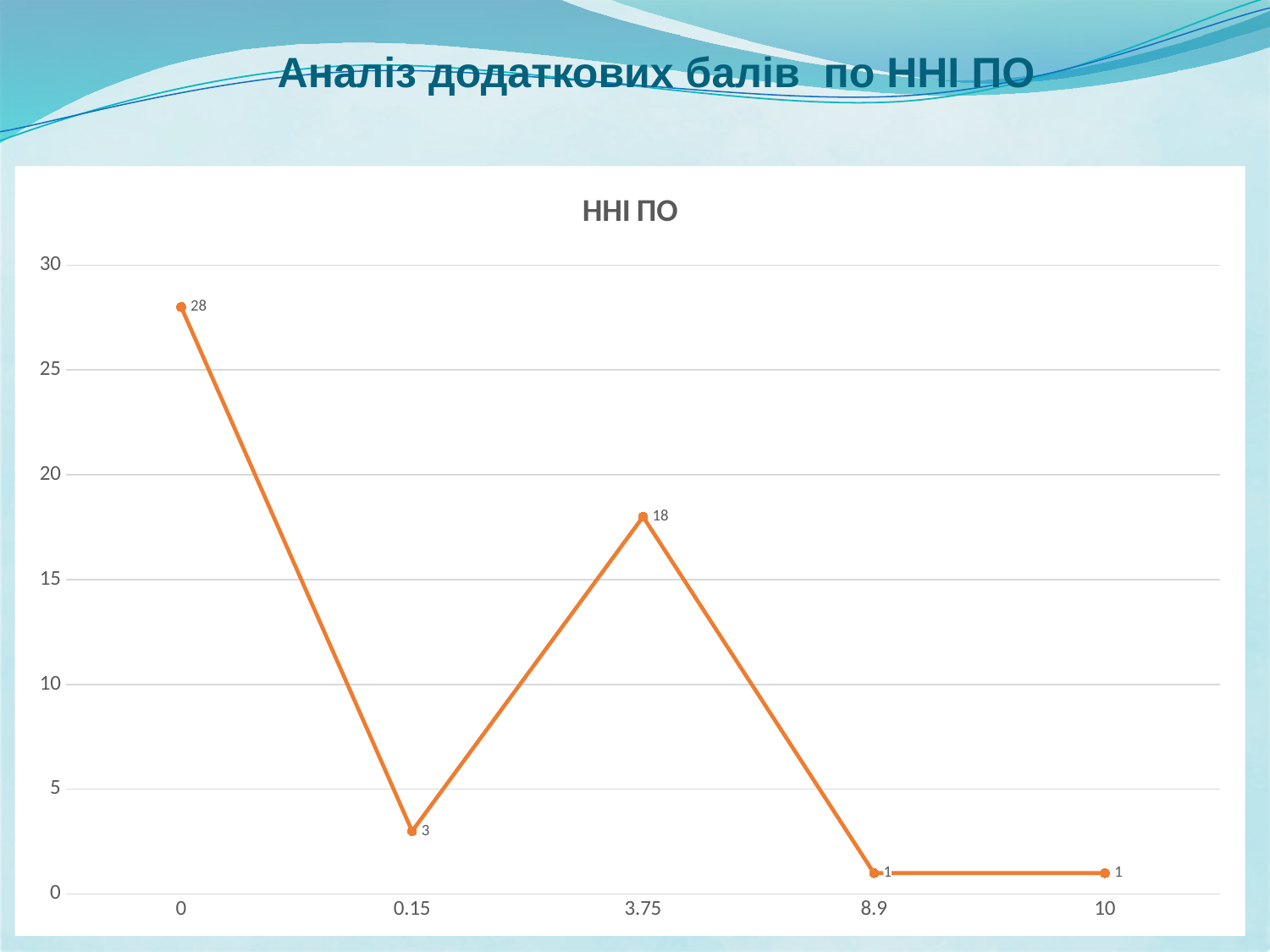
What is the difference between the values at 0 and 3.75? 10 What kind of chart is shown? line chart Which category has the highest value? 0 What is the title of the chart? ННІ ПО What is the value at category 0.15? 3 What is the value at category 8.9? 1 What is the value at category 3.75? 18 What is the value at category 0? 28 Which is larger, the value at 0.15 or the value at 3.75? 3.75 How many data points are plotted on the chart? 5 Does the value rise or fall from category 0 to category 0.15? fall Is the value at 3.75 greater or less than 15? greater